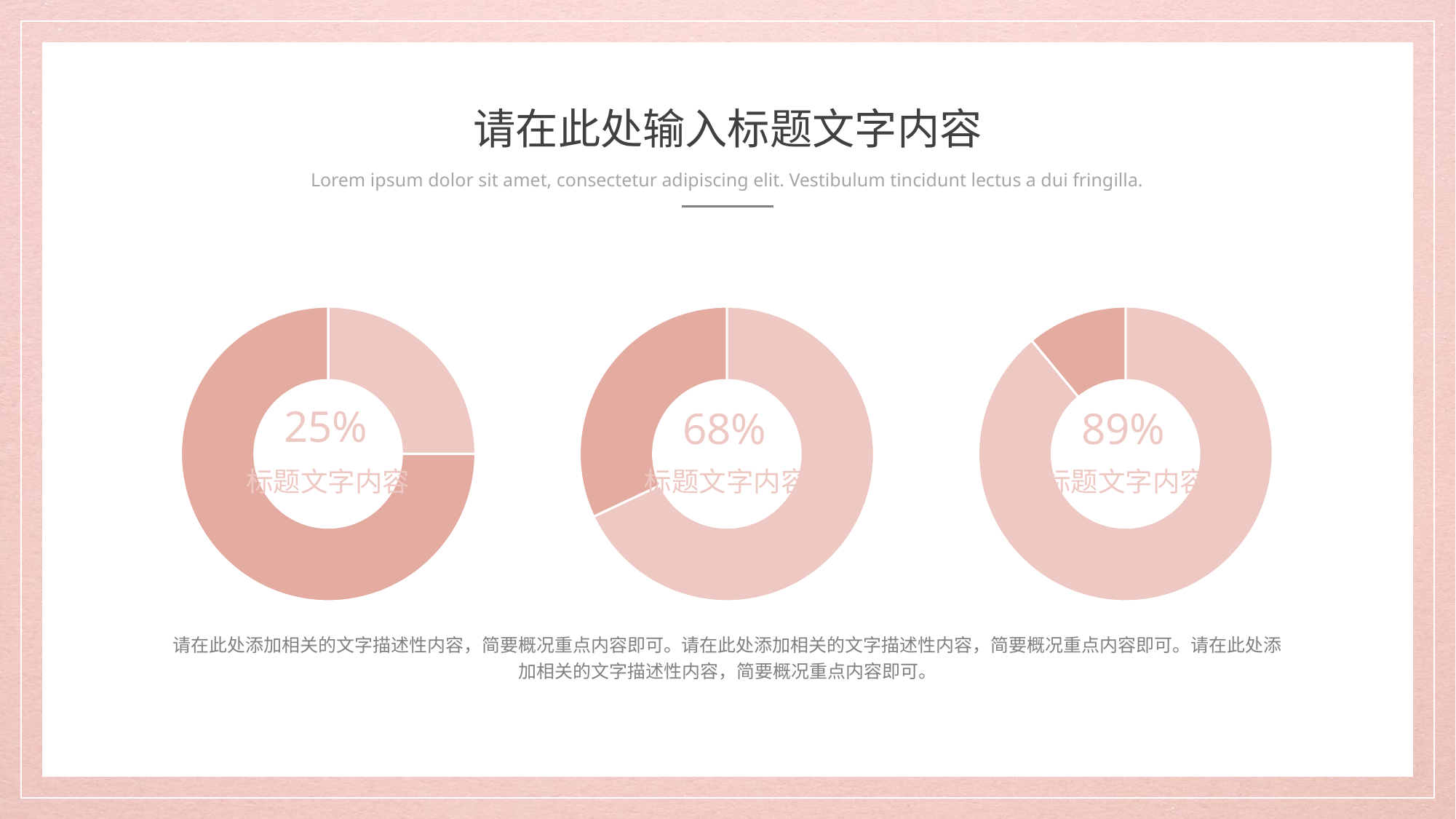
What kind of chart is used on this slide? Donut (pie) chart Which is larger, the percentage in the middle donut chart or the percentage in the right donut chart? The right chart (89%) What percentage is shown in the centre of the right donut chart? 89% Which of the three donut charts shows the lowest percentage? The left chart (25%) How many donut charts are on the slide? 3 How many slices does each donut chart have? 2 What is the difference between the percentage in the middle donut chart and the percentage in the left donut chart? 43% Which of the three donut charts shows the highest percentage? The right chart (89%) What percentage is shown in the centre of the left donut chart? 25% What text label appears below the percentage in the left donut chart? 标题文字内容 What percentage is shown in the centre of the middle donut chart? 68% What is the difference between the percentage in the right donut chart and the percentage in the left donut chart? 64%